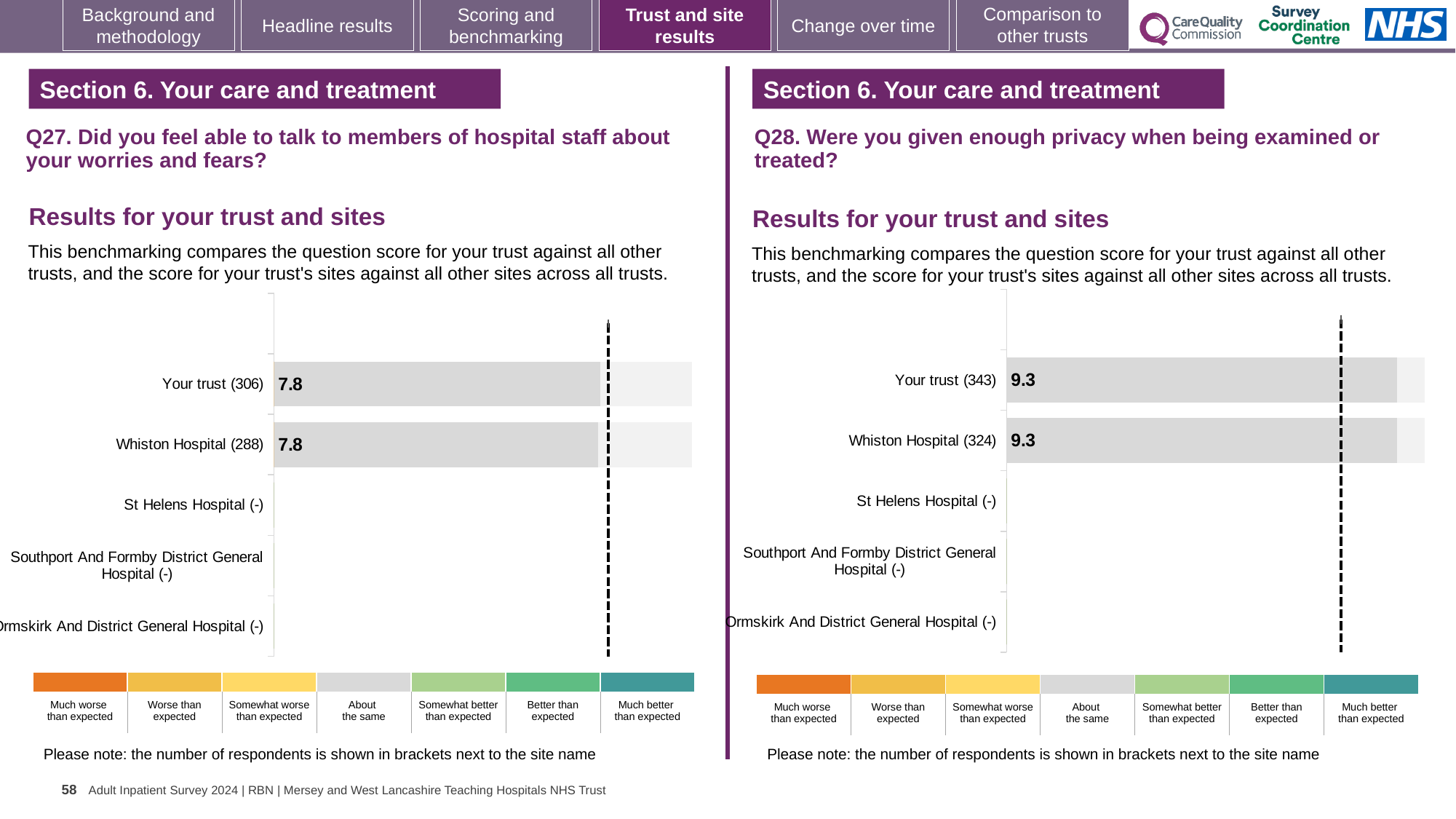
Is the score for Your trust in the Q28 chart on the right larger or smaller than the score for Your trust in the Q27 chart on the left? Larger How many site/trust categories are listed on the y axis of the Q28 chart on the right? 5 In the Q27 chart on the left, what is the difference between the scores for Your trust and Whiston Hospital? 0 In the Q27 chart on the left, what is the score for Your trust? 7.8 In the Q28 chart on the right, what is the difference between the scores for Your trust and Whiston Hospital? 0 In the Q27 chart on the left, what is the score for Whiston Hospital? 7.8 In the Q28 chart on the right, what is the score for Whiston Hospital? 9.3 How many site/trust categories are listed on the y axis of the Q27 chart on the left? 5 In the Q28 chart on the right, what is the score for Your trust? 9.3 What kind of chart is used for the Q27 results on the left? Bar chart In the Q28 chart on the right, how many respondents are shown in brackets for Whiston Hospital? 324 In the Q27 chart on the left, how many respondents are shown in brackets for Your trust? 306